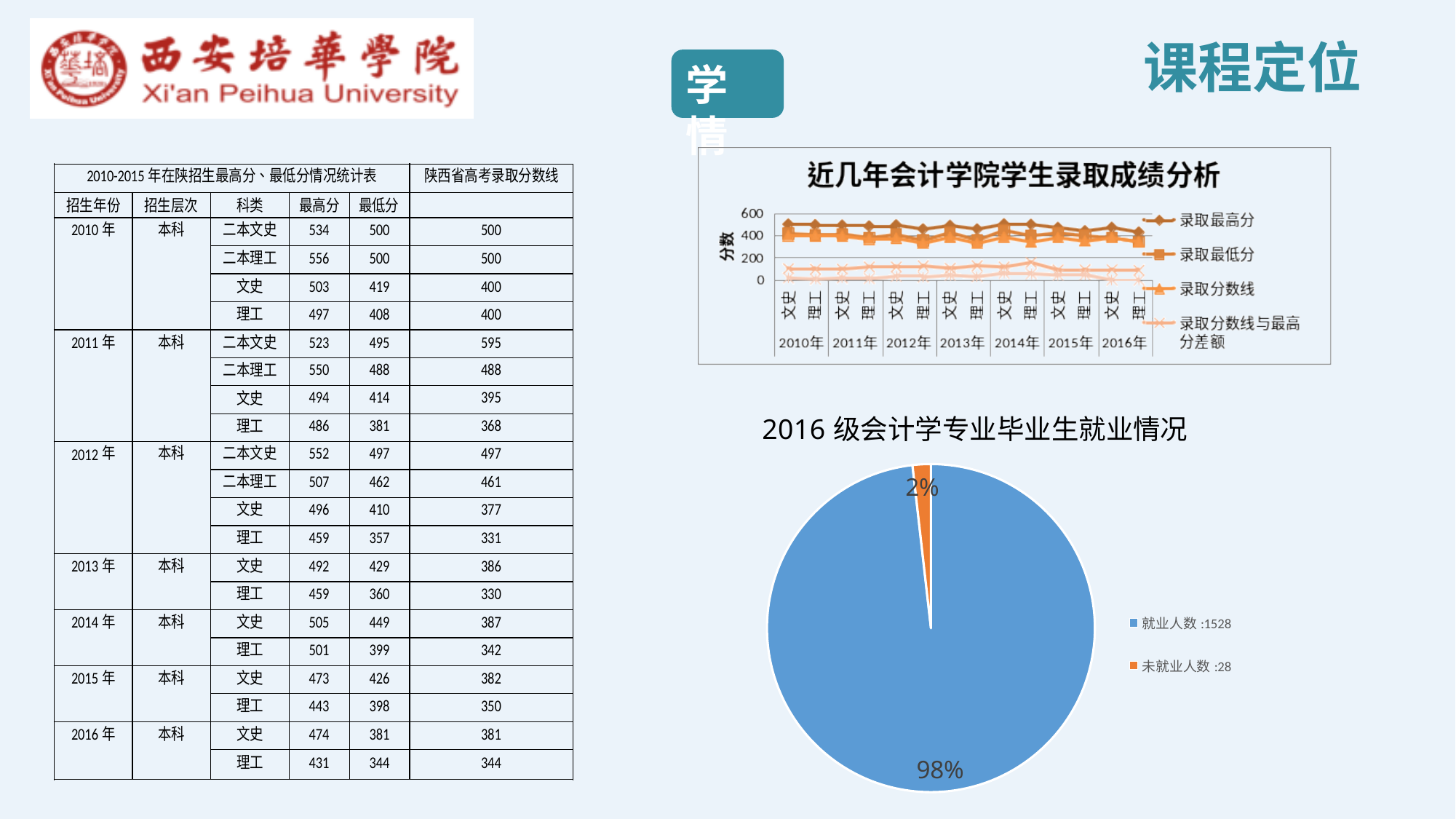
In the chart titled 近几年会计学院学生录取成绩分析, is the 录取分数线与最高分差额 value for 理工 in 2016年 greater or less than 200? less What kind of chart is the chart titled 近几年会计学院学生录取成绩分析? line chart In the pie chart titled 2016 级会计学专业毕业生就业情况, what share of the pie is 未就业人数? 2% In the chart titled 近几年会计学院学生录取成绩分析, how many years are shown on the x axis? 7 In the pie chart titled 2016 级会计学专业毕业生就业情况, what is the difference between 就业人数 and 未就业人数? 1500 How many series does the legend of the chart titled 近几年会计学院学生录取成绩分析 list? 4 In the pie chart titled 2016 级会计学专业毕业生就业情况, what share of the pie is 就业人数? 98% In the pie chart titled 2016 级会计学专业毕业生就业情况, what is the value for 未就业人数? 28 What kind of chart is the chart titled 2016 级会计学专业毕业生就业情况? pie chart In the pie chart titled 2016 级会计学专业毕业生就业情况, what colour is the 未就业人数 slice? orange In the chart titled 近几年会计学院学生录取成绩分析, which series is plotted lowest on the chart? 录取分数线与最高分差额 In the chart titled 近几年会计学院学生录取成绩分析, is the 录取最高分 value for 文史 in 2010年 greater or less than 400? greater